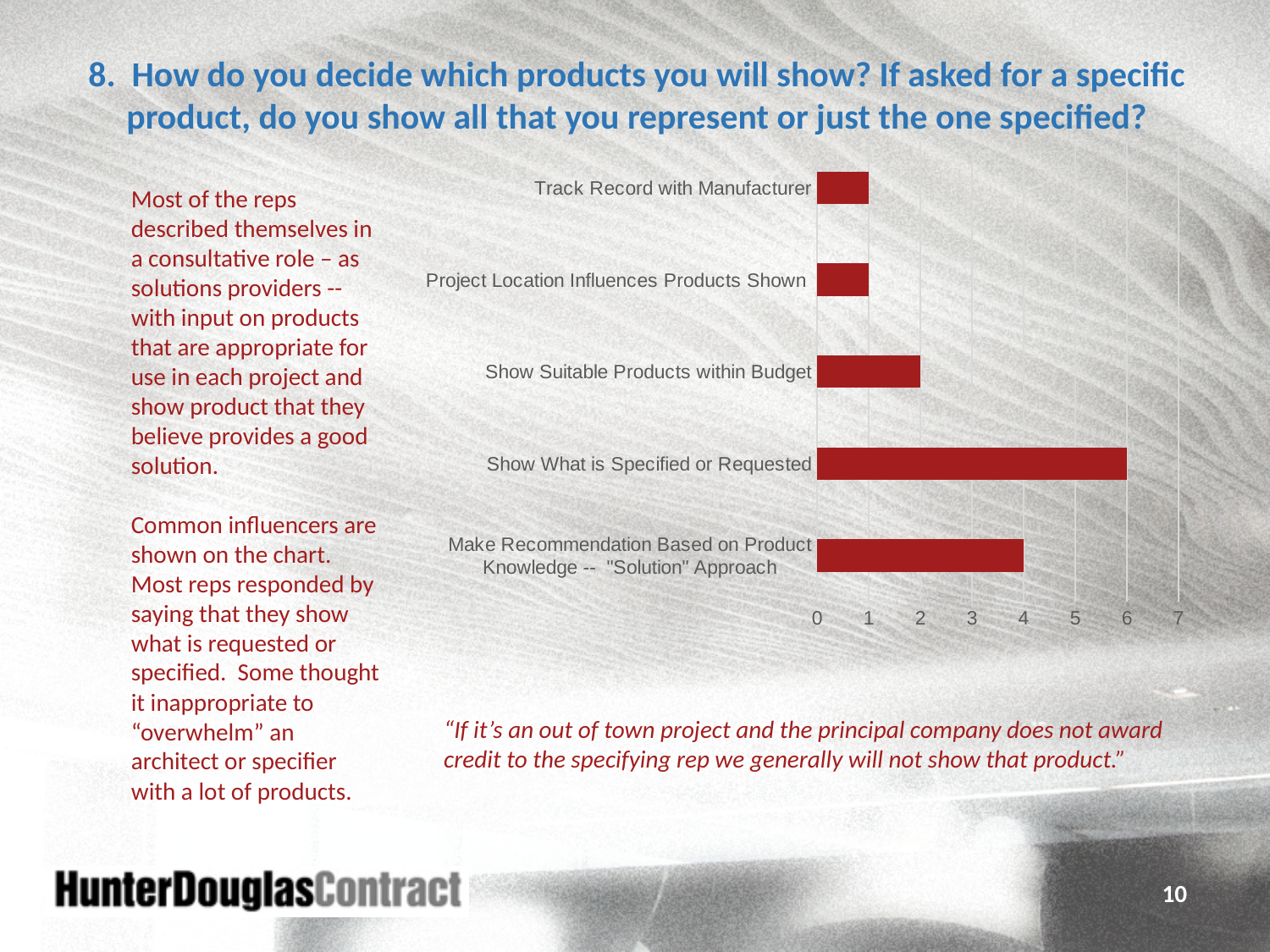
Is the value for "Project Location Influences Products Shown" greater or less than 3? less What type of chart is shown on the slide? bar chart Is the value for "Show What is Specified or Requested" greater or less than 5? greater What is the value for "Show Suitable Products within Budget"? 2 How many categories are plotted in the chart? 5 What is the value for "Track Record with Manufacturer"? 1 What is the highest value shown on the horizontal axis of the chart? 7 Which category has the highest value in the chart? Show What is Specified or Requested Which is larger: the value for "Show What is Specified or Requested" or the value for "Make Recommendation Based on Product Knowledge -- "Solution" Approach"? Show What is Specified or Requested What is the difference between the values for "Show What is Specified or Requested" and "Show Suitable Products within Budget"? 4 What is the value for "Show What is Specified or Requested"? 6 What is the value for "Make Recommendation Based on Product Knowledge -- "Solution" Approach"? 4